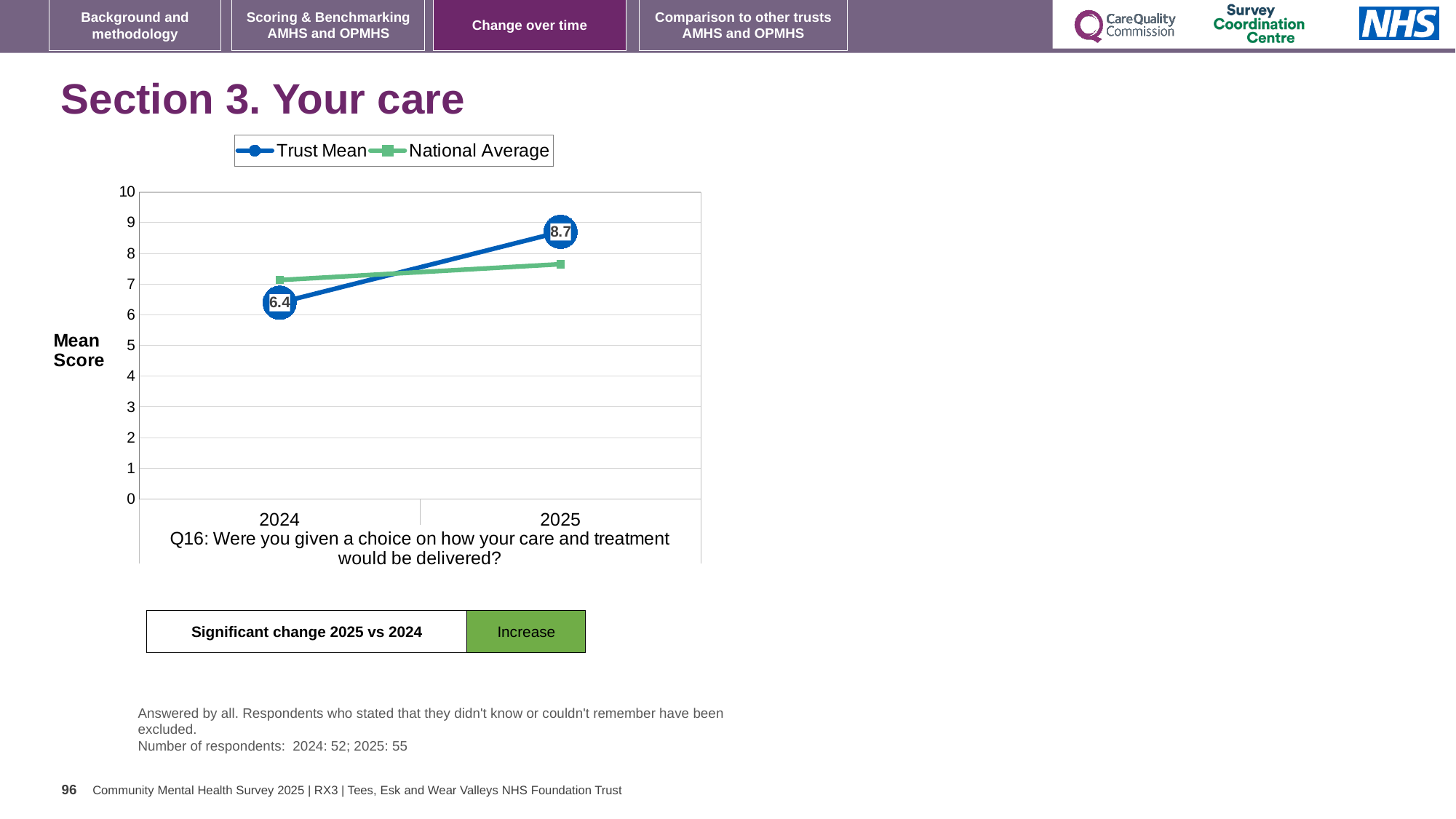
By how much did the Trust Mean change from 2024 to 2025? 2.3 What is the Trust Mean score for 2025? 8.7 What is the label on the y axis of the chart? Mean Score Does the Trust Mean rise or fall from 2024 to 2025? rise Which year has the higher Trust Mean score? 2025 In 2024, which is larger: the Trust Mean or the National Average? National Average What is the Trust Mean score for 2024? 6.4 How many series does the legend list? 2 What kind of chart is shown on the slide? line chart In 2025, which is larger: the Trust Mean or the National Average? Trust Mean Is the National Average for 2025 greater or less than 8? less